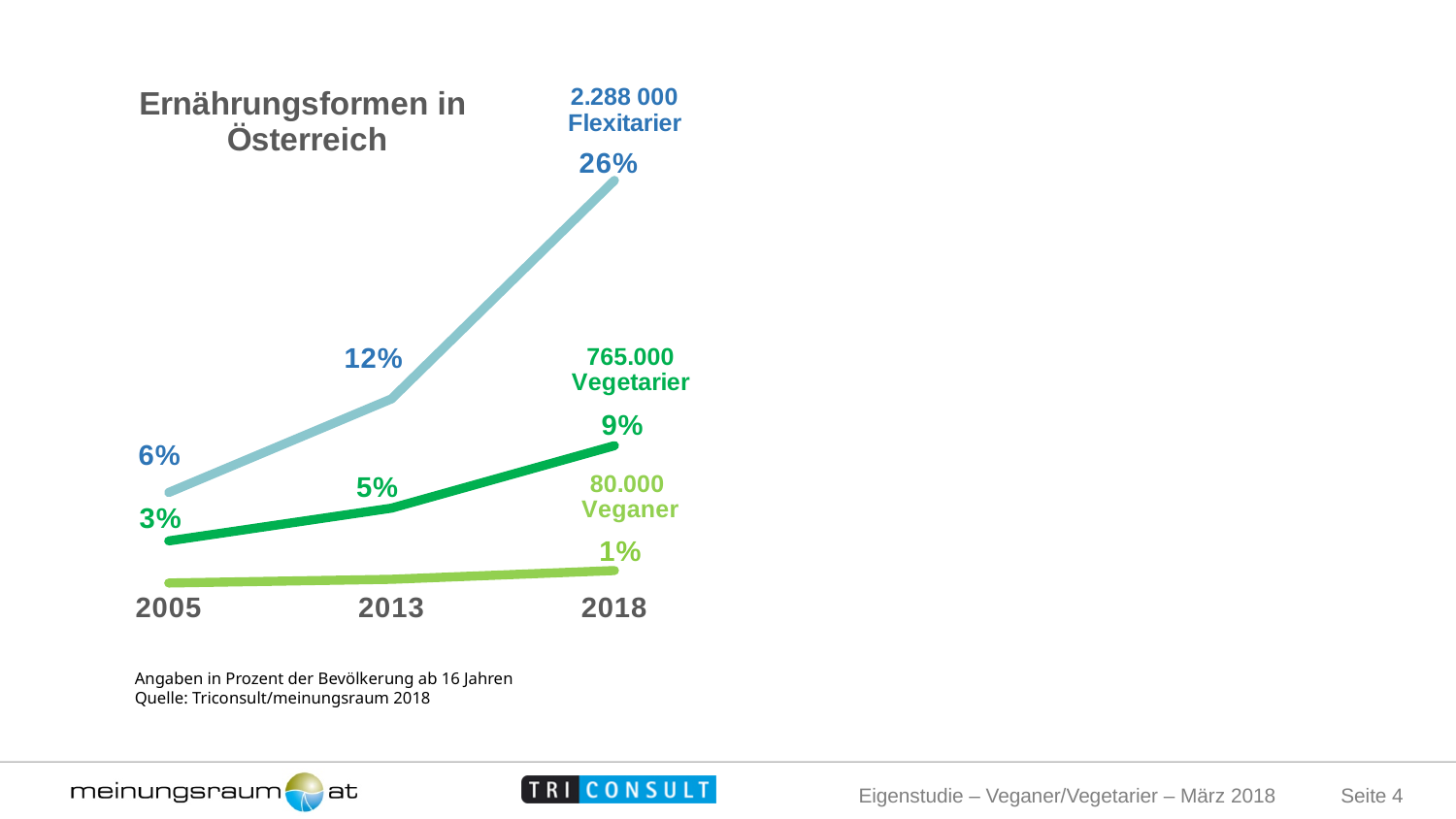
Which group has the lowest percentage in 2018? Veganer How many lines (series) are plotted in the chart? 3 Which group has the highest percentage in 2018? Flexitarier What is the title of the chart? Ernährungsformen in Österreich What percentage is shown for Vegetarier in 2005? 3% How many years are shown on the x axis? 3 What percentage is shown for Flexitarier in 2013? 12% What is the difference between the Flexitarier percentage in 2018 and in 2005? 20% Does the Vegetarier line rise or fall from 2005 to 2018? rise What kind of chart is shown on the slide? line chart What percentage is shown for Veganer in 2018? 1% What percentage is shown for Flexitarier in 2018? 26%